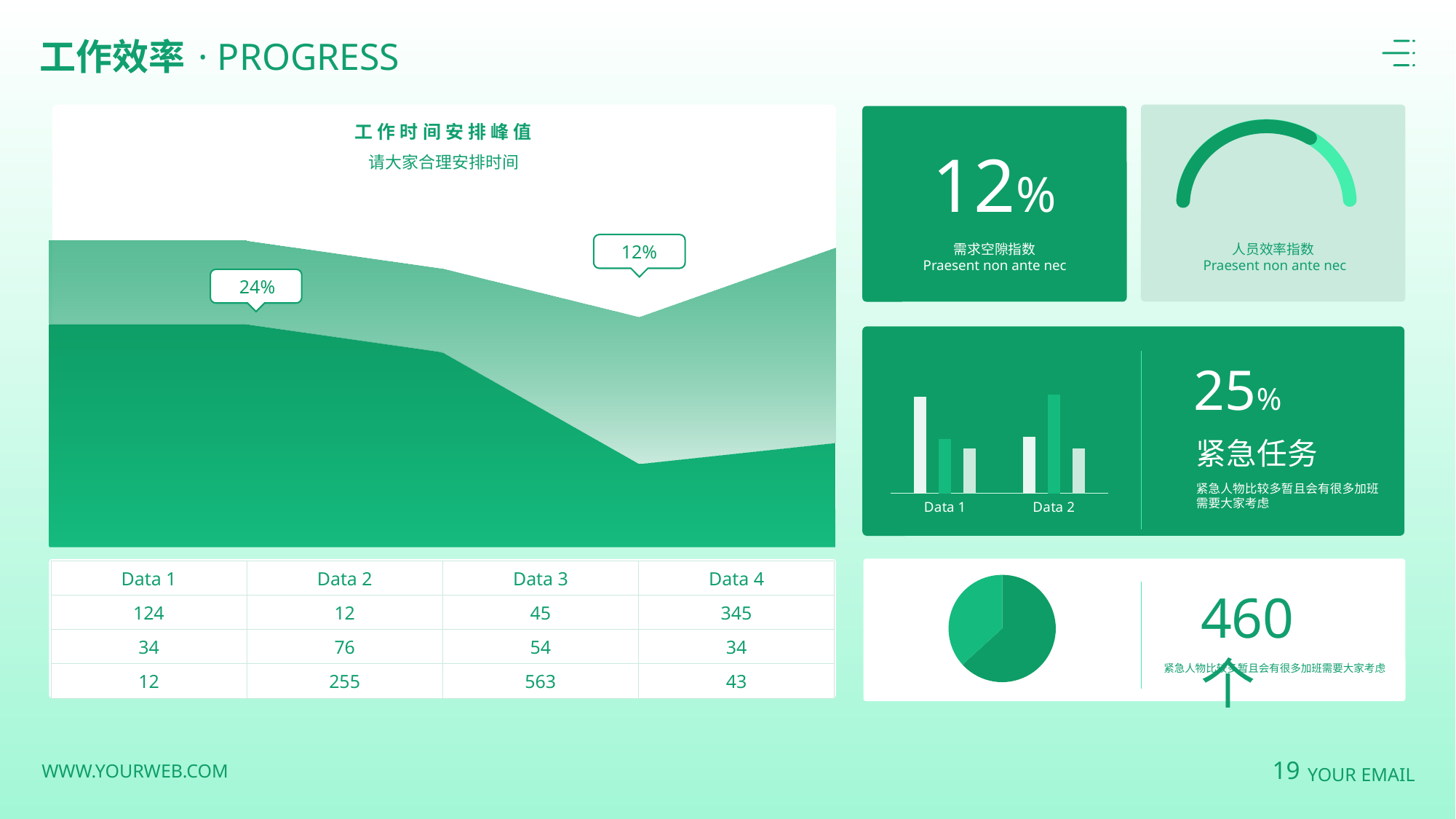
How many slices does the pie chart in the bottom-right card (next to 460) have? 2 In the bar chart in the 紧急任务 card, how many bars are drawn for each category? 3 In the area chart titled 工作时间安排峰值, which callout shows the larger value, the left one or the right one? the left one (24%) In the area chart titled 工作时间安排峰值, what is the difference between the two callout values, 24% and 12%? 12% How many shaded series are plotted in the area chart titled 工作时间安排峰值? 2 What kind of chart is shown in the 紧急任务 card on the right of the slide? bar chart What kind of chart is the large chart on the left of the slide under the title 工作时间安排峰值? area chart In the area chart titled 工作时间安排峰值, what value is shown in the left callout label? 24% What are the category labels on the x axis of the bar chart in the 紧急任务 card? Data 1, Data 2 How many categories are shown on the x axis of the bar chart in the 紧急任务 card? 2 In the area chart titled 工作时间安排峰值, what value is shown in the right callout label? 12% What is the title of the area chart on the left of the slide? 工作时间安排峰值